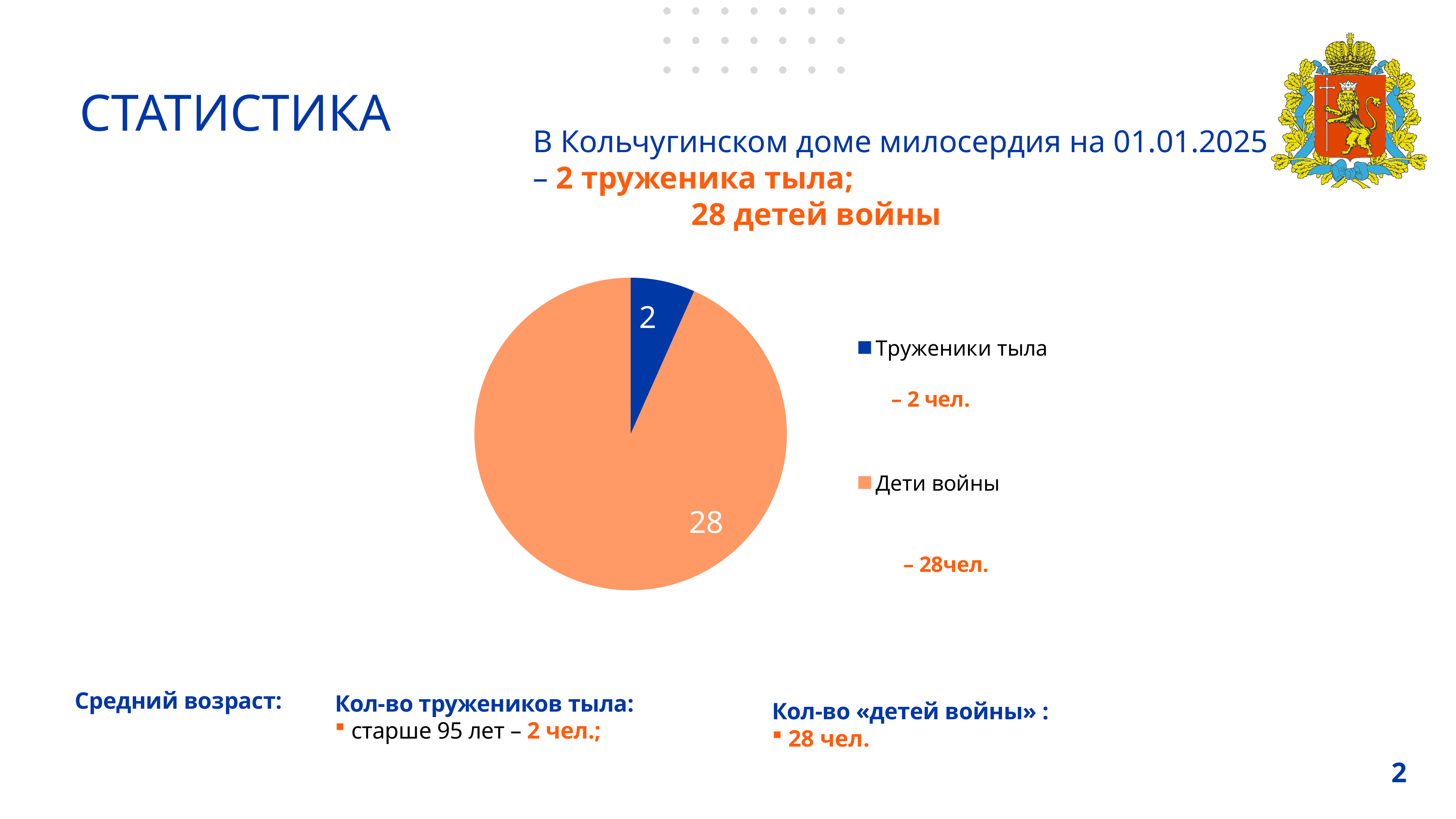
What is the total of all slices in the pie chart? 30 What kind of chart is shown on the slide? pie chart How many entries does the legend list? 2 What is the value for Труженики тыла in the pie chart? 2 What is the value for Дети войны in the pie chart? 28 How many categories does the pie chart have? 2 Which is larger, the value for Труженики тыла or the value for Дети войны? Дети войны Which category has the largest slice in the pie chart? Дети войны What colour is the slice for Труженики тыла? blue Which category has the smallest slice in the pie chart? Труженики тыла What colour is the slice for Дети войны? orange What is the difference between the values for Дети войны and Труженики тыла? 26